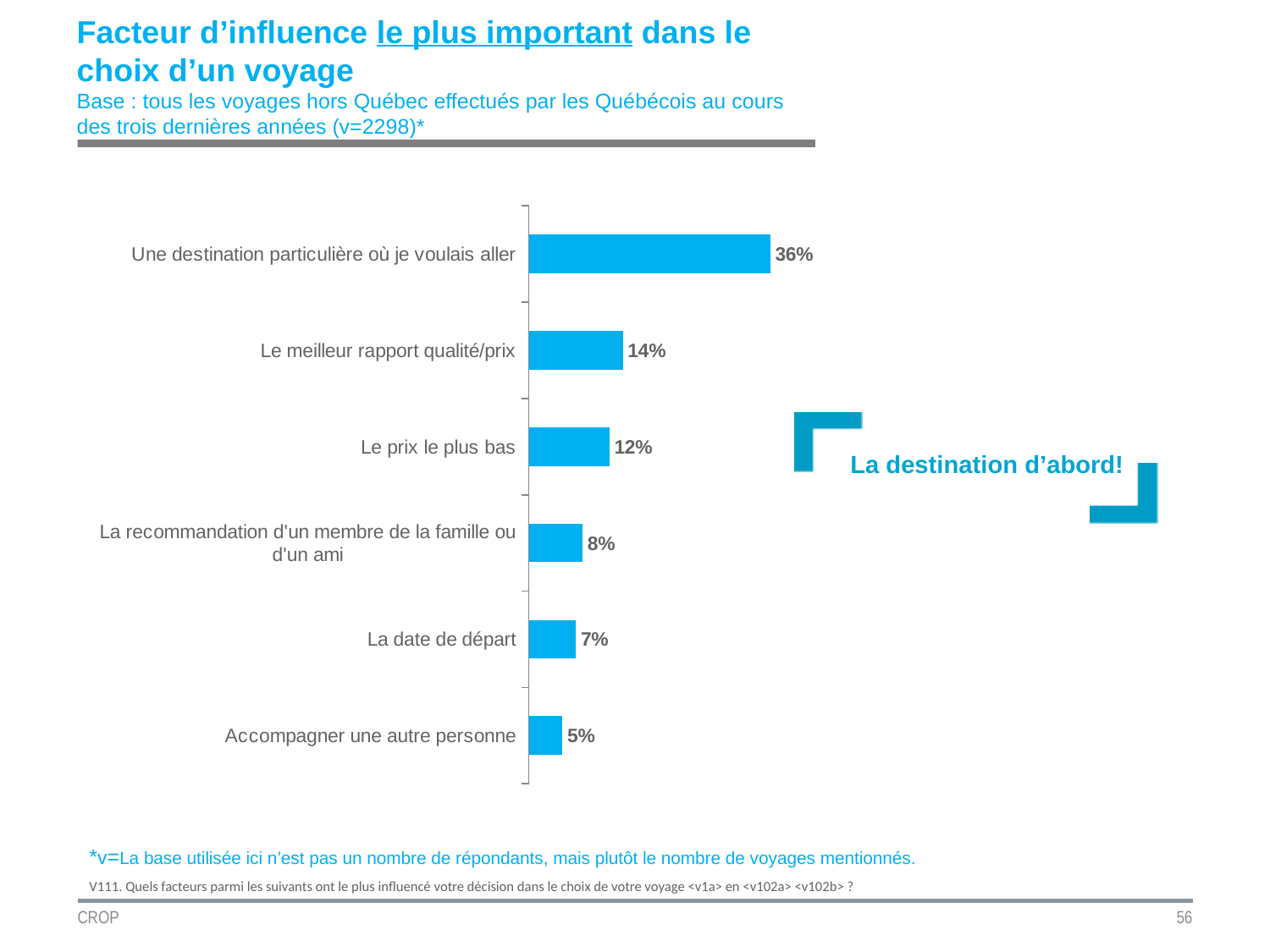
What is the value for "Le meilleur rapport qualité/prix"? 14% What is the value for "Une destination particulière où je voulais aller"? 36% Which category has the lowest value? Accompagner une autre personne Which category has the highest value? Une destination particulière où je voulais aller What is the value for "Le prix le plus bas"? 12% What is the difference between "Une destination particulière où je voulais aller" and "Le meilleur rapport qualité/prix"? 22% What is the difference between "La recommandation d'un membre de la famille ou d'un ami" and "Accompagner une autre personne"? 3% How many categories are shown in the chart? 6 Which is larger: "Le prix le plus bas" or "La date de départ"? Le prix le plus bas What is the value for "La date de départ"? 7% What kind of chart is shown on the slide? Bar chart What is the text of the callout next to the chart? La destination d'abord!